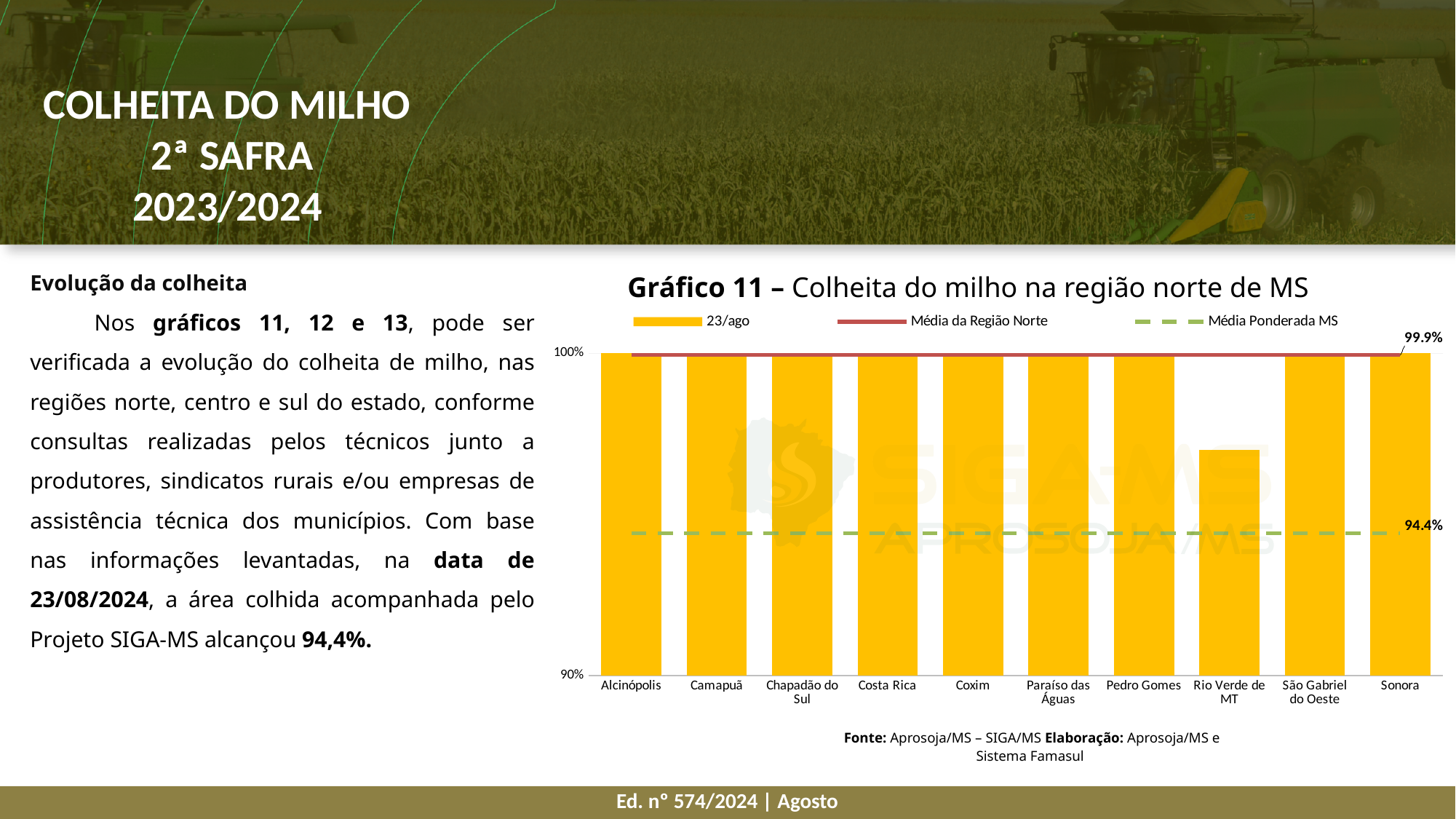
What is the value of the Média da Região Norte line in Gráfico 11? 99.9% What legend label is given to the yellow bars in Gráfico 11? 23/ago What is the title of the chart on the slide? Gráfico 11 – Colheita do milho na região norte de MS How many series does the legend of Gráfico 11 list? 3 What kind of chart is Gráfico 11? bar chart How many municipalities are shown on the x axis of Gráfico 11? 10 In Gráfico 11, which is higher: the Média da Região Norte or the Média Ponderada MS? Média da Região Norte In Gráfico 11, what is the difference between the Média da Região Norte (99.9%) and the Média Ponderada MS (94.4%)? 5.5 percentage points What is the value of the Média Ponderada MS line in Gráfico 11? 94.4% In Gráfico 11, is the value for Rio Verde de MT greater or less than 100%? less Which municipality has the lowest bar in Gráfico 11? Rio Verde de MT In Gráfico 11, which bar is taller: Rio Verde de MT or Sonora? Sonora